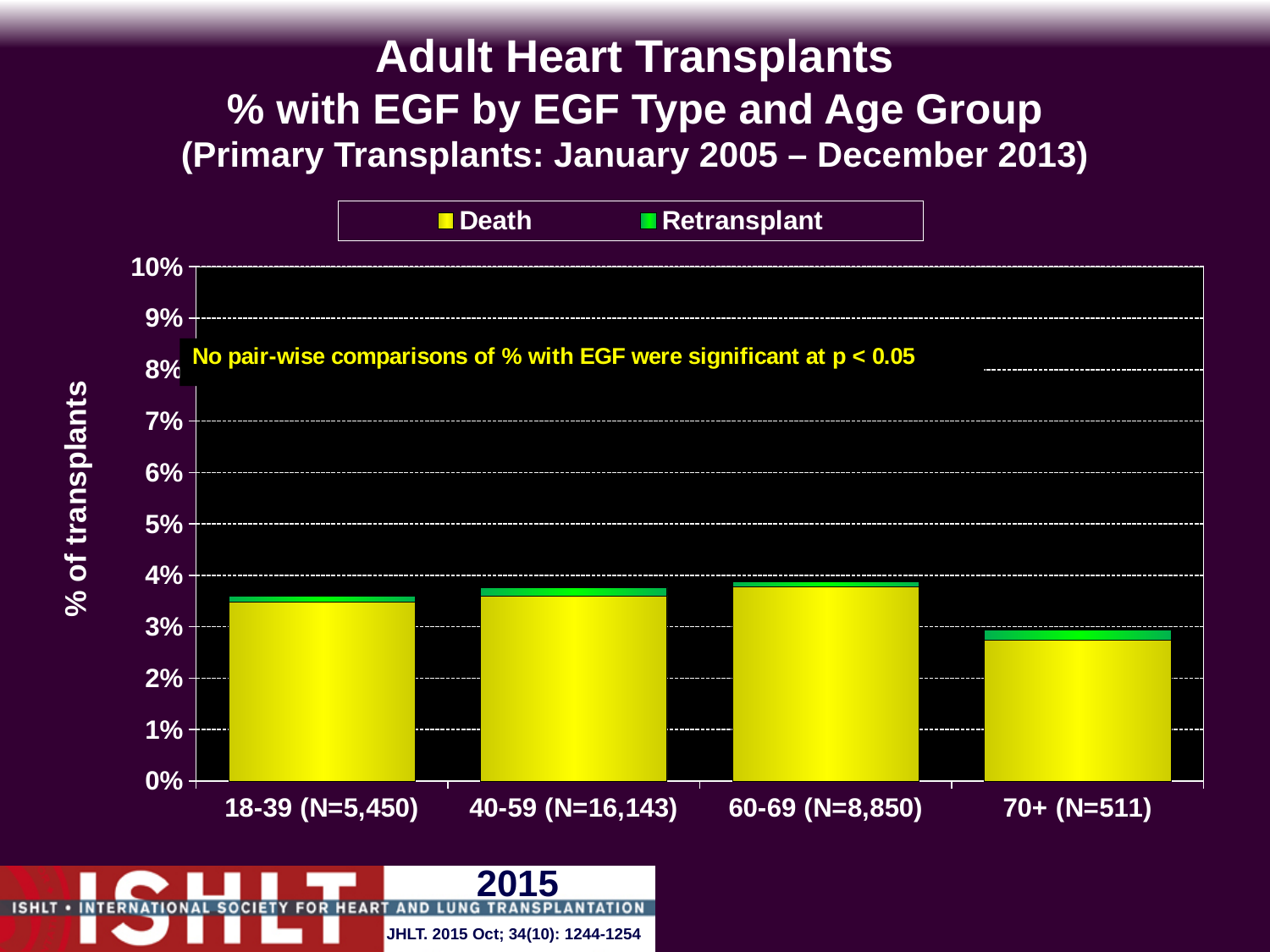
Which age group has the highest total % with EGF? 60-69 (N=8,850) How many age groups are shown on the x axis? 4 Which series is shown in yellow in the legend? Death Is the total % with EGF for the 40-59 age group greater or less than 5%? less Which has a larger total % with EGF: the 60-69 age group or the 70+ age group? 60-69 (N=8,850) What kind of chart is shown on the slide? bar chart What is the label on the y axis? % of transplants How many series does the legend list? 2 Which age group has the lowest total % with EGF? 70+ (N=511) Which has a larger total % with EGF: the 18-39 age group or the 70+ age group? 18-39 (N=5,450) Is the total % with EGF for the 18-39 age group greater or less than 3%? greater Is the total % with EGF for the 60-69 age group greater or less than 4%? less